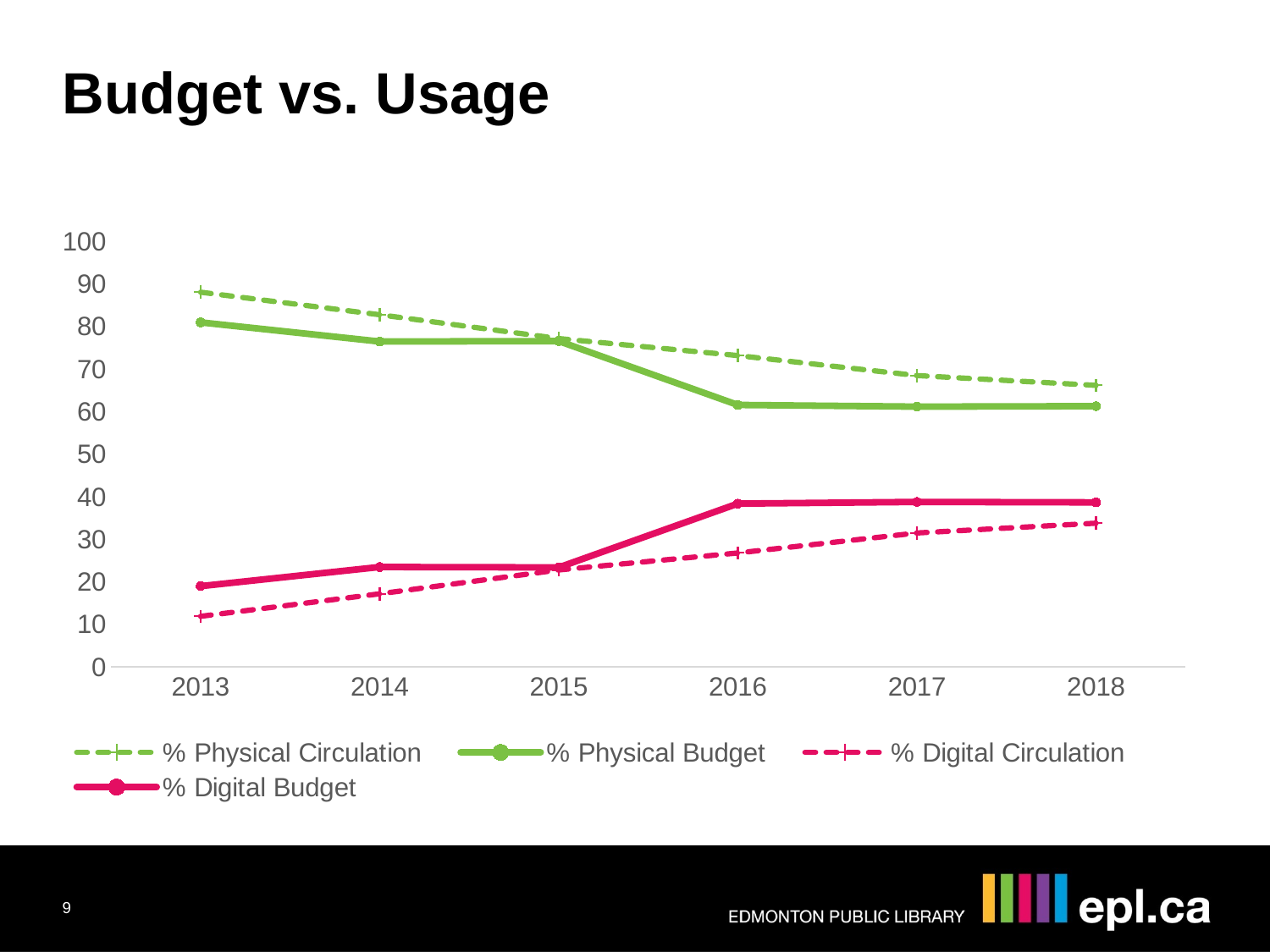
What is the title of the slide's chart? Budget vs. Usage Is the value for % Digital Circulation in 2013 greater or less than 20? less Does % Digital Circulation rise or fall from 2013 to 2018? Rise In 2016, which is larger: % Physical Circulation or % Physical Budget? % Physical Circulation Is the value for % Physical Circulation in 2013 greater or less than 80? greater How many series does the legend list? 4 Does % Physical Circulation rise or fall from 2013 to 2018? Fall Is the value for % Digital Budget in 2018 greater or less than 30? greater What kind of chart is shown on the slide? Line chart How many years are shown on the x axis? 6 In which year is % Physical Circulation highest? 2013